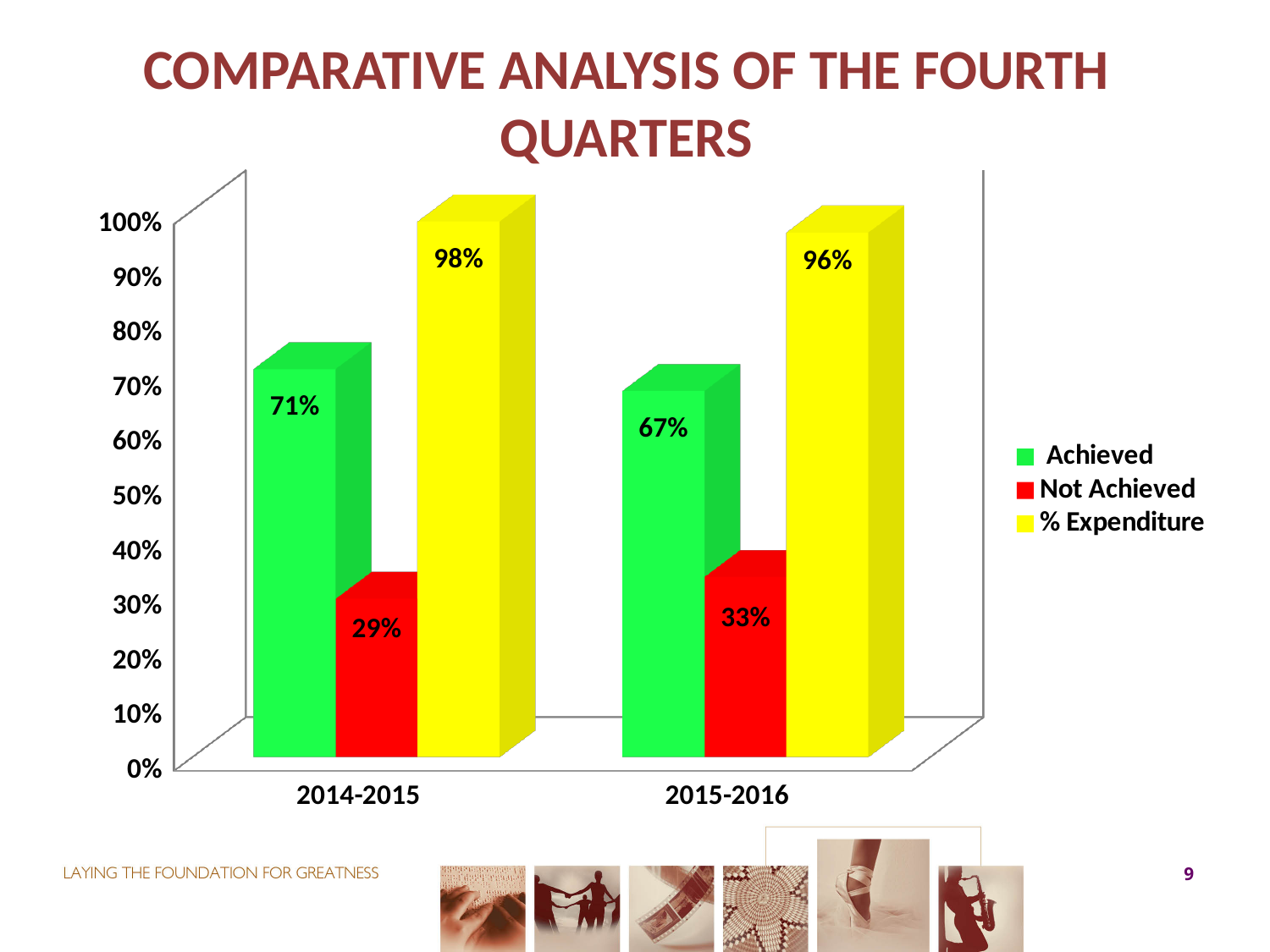
What is the % Expenditure value for 2014-2015? 98% What is the Achieved value for 2015-2016? 67% Which is larger, the Not Achieved value for 2014-2015 or for 2015-2016? 2015-2016 What is the difference between the Achieved values for 2014-2015 and 2015-2016? 4% How many categories are shown on the x axis? 2 What kind of chart is shown on the slide? Bar chart Which category has the lowest Not Achieved value? 2014-2015 Which category has the highest % Expenditure value? 2014-2015 What is the Not Achieved value for 2015-2016? 33% How many series does the legend list? 3 What is the Achieved value for 2014-2015? 71% Which colour represents the Not Achieved series? Red